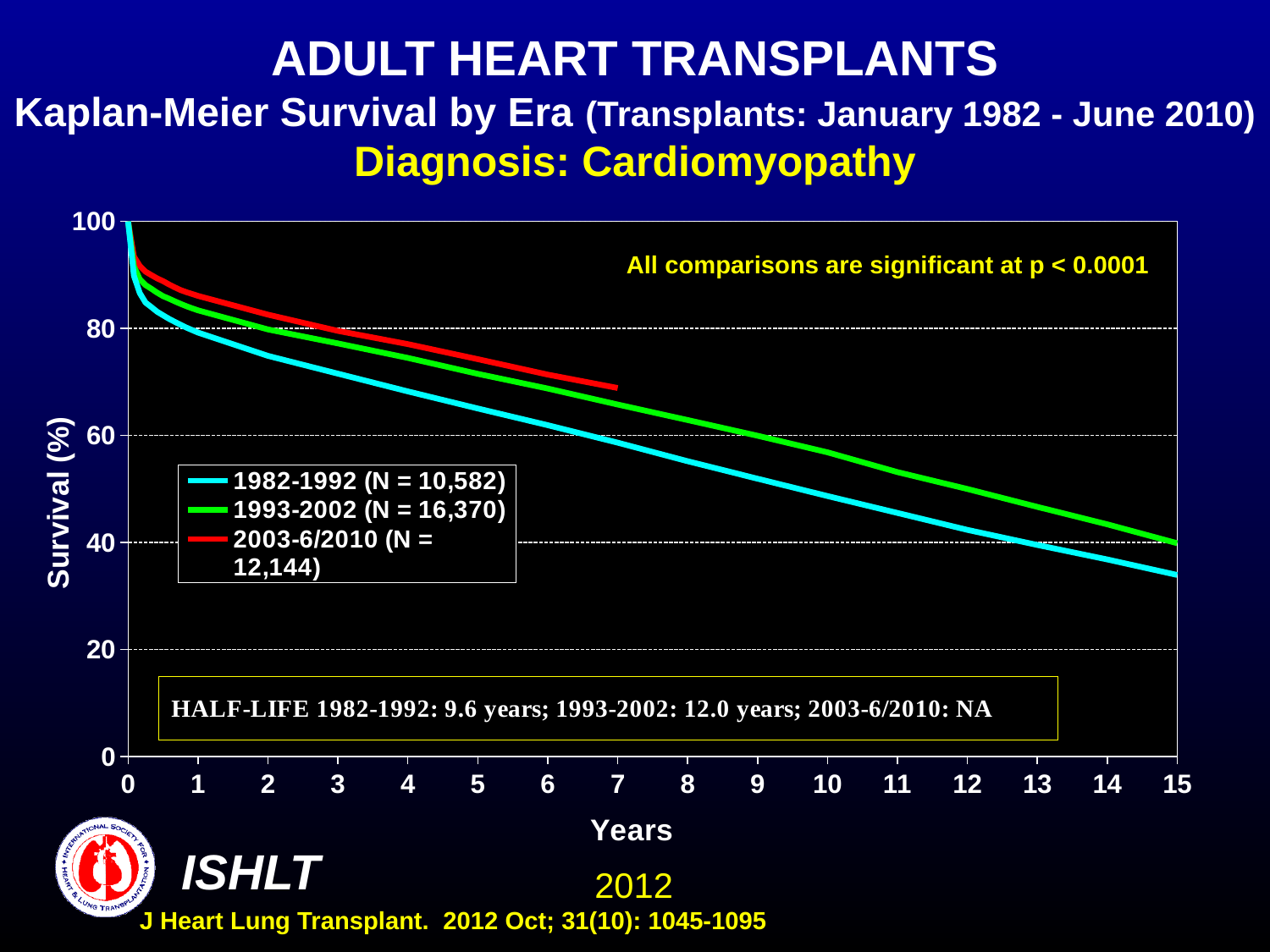
Is the survival for the 1982-1992 era at 15 years greater or less than 40? less Which era has the lowest survival at 10 years? 1982-1992 What is the half-life for the 1993-2002 era? 12.0 years What is the N for the 1993-2002 era in the legend? 16,370 What is the N for the 2003-6/2010 era in the legend? 12,144 What is the half-life for the 1982-1992 era? 9.6 years Is the survival for the 2003-6/2010 era at 7 years greater or less than 60? greater Which era has the highest survival at 5 years? 2003-6/2010 What is the N for the 1982-1992 era in the legend? 10,582 How many series does the legend list? 3 What kind of chart is shown on the slide? line chart Do the survival curves rise or fall as years increase? fall